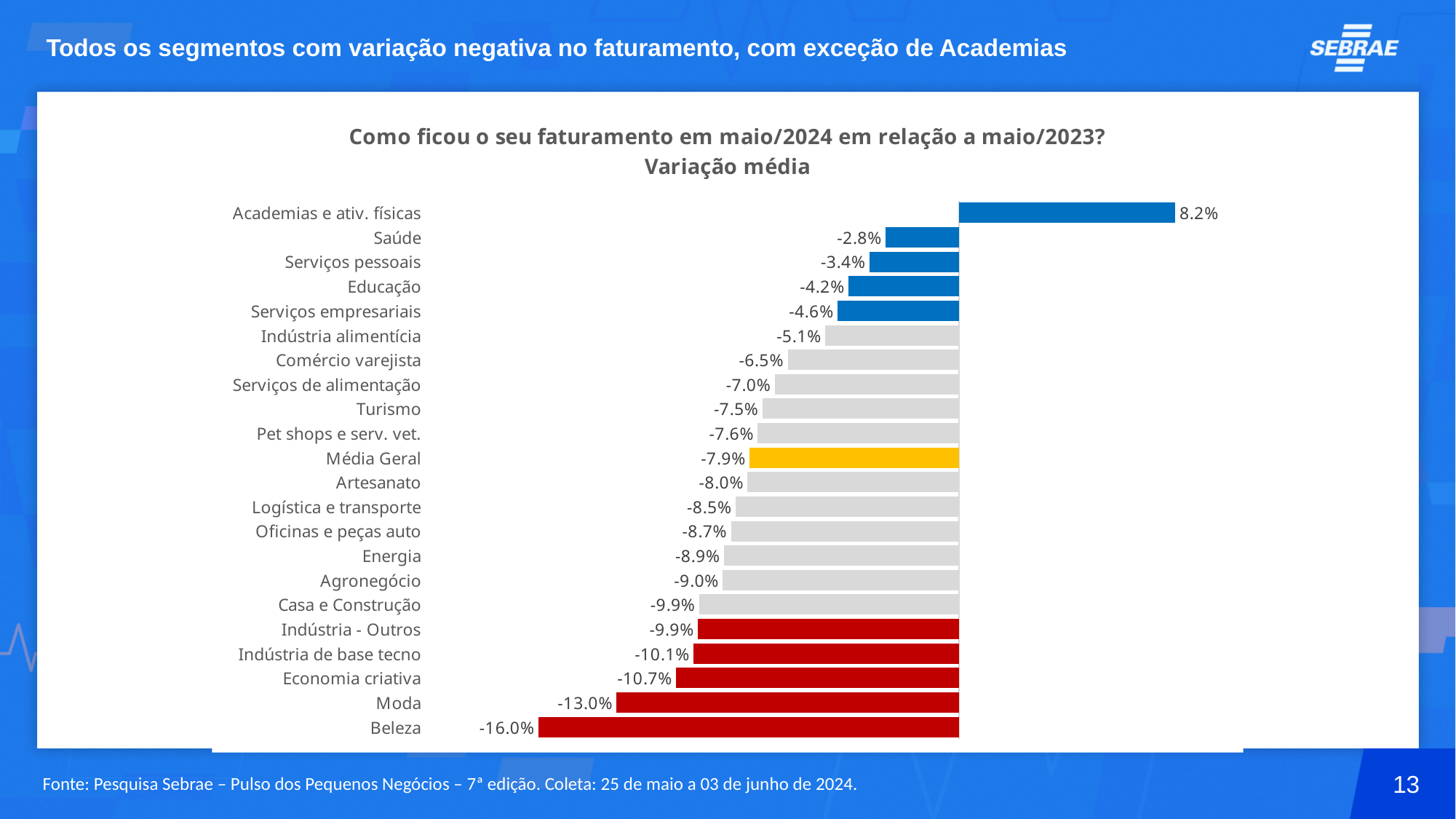
Which category has the highest value? Academias e ativ. físicas What is the value shown for Academias e ativ. físicas? 8.2% How many categories are shown in the chart? 22 Which category has the lowest value? Beleza What is the value shown for Comércio varejista? -6.5% What is the difference in percentage points between Moda and Beleza? 3.0 percentage points What colour is the bar for Média Geral? Yellow Which has the larger value, Turismo or Energia? Turismo What is the value shown for Média Geral? -7.9% What is the value shown for Moda? -13.0% What is the difference in percentage points between Saúde and Média Geral? 5.1 percentage points What kind of chart is shown on the slide? Bar chart